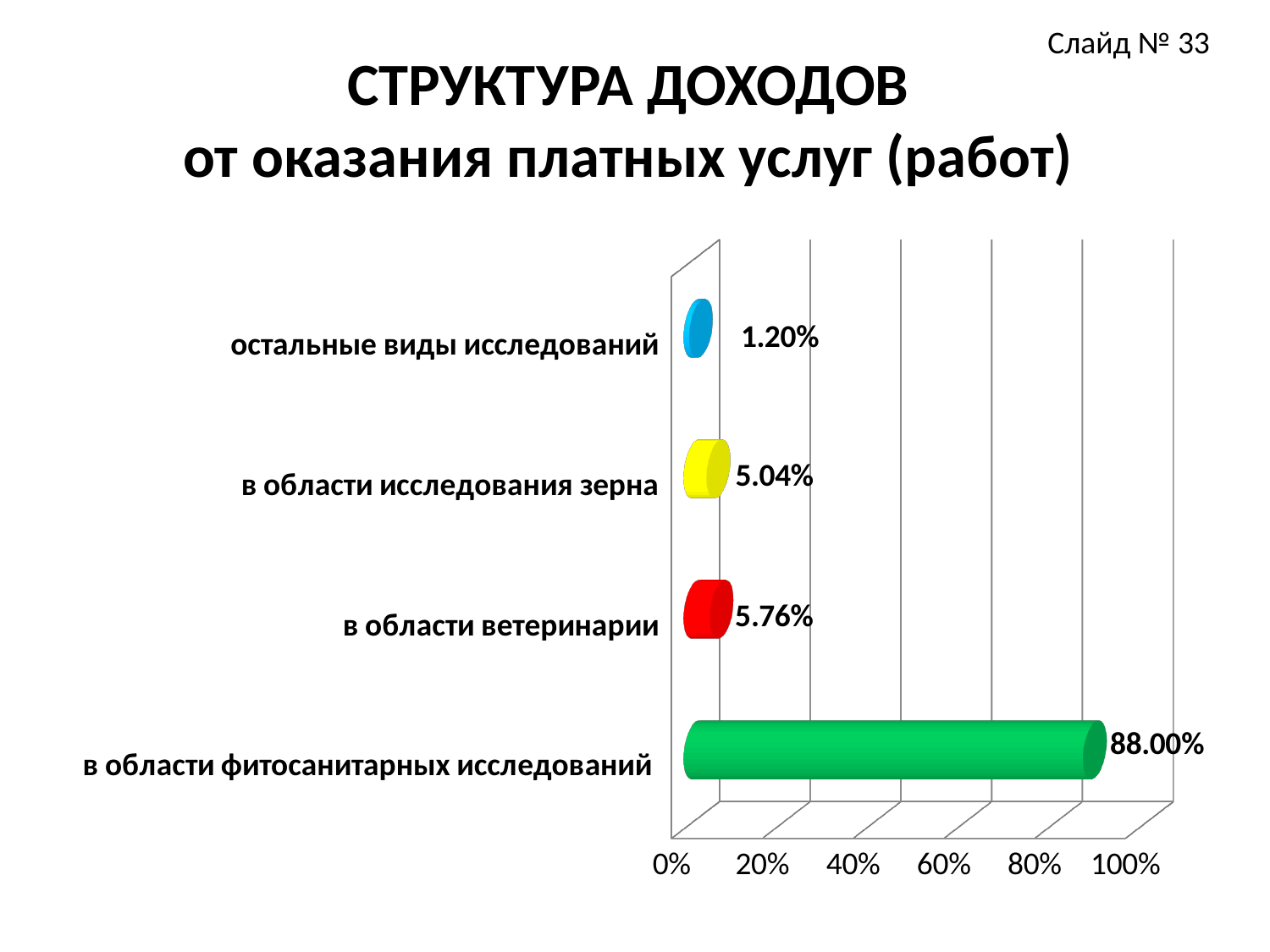
Is the value for в области фитосанитарных исследований greater or less than 80%? greater What is the difference between the values for в области ветеринарии and в области исследования зерна? 0.72% Which is larger, the value for в области ветеринарии or the value for в области исследования зерна? в области ветеринарии What kind of chart is shown on the slide? bar chart What is the value for в области ветеринарии? 5.76% Which category has the lowest value? остальные виды исследований What is the value for в области фитосанитарных исследований? 88.00% What is the value for остальные виды исследований? 1.20% Which category has the highest value? в области фитосанитарных исследований How many categories are shown in the chart? 4 What is the difference between the values for в области фитосанитарных исследований and остальные виды исследований? 86.80% What is the value for в области исследования зерна? 5.04%